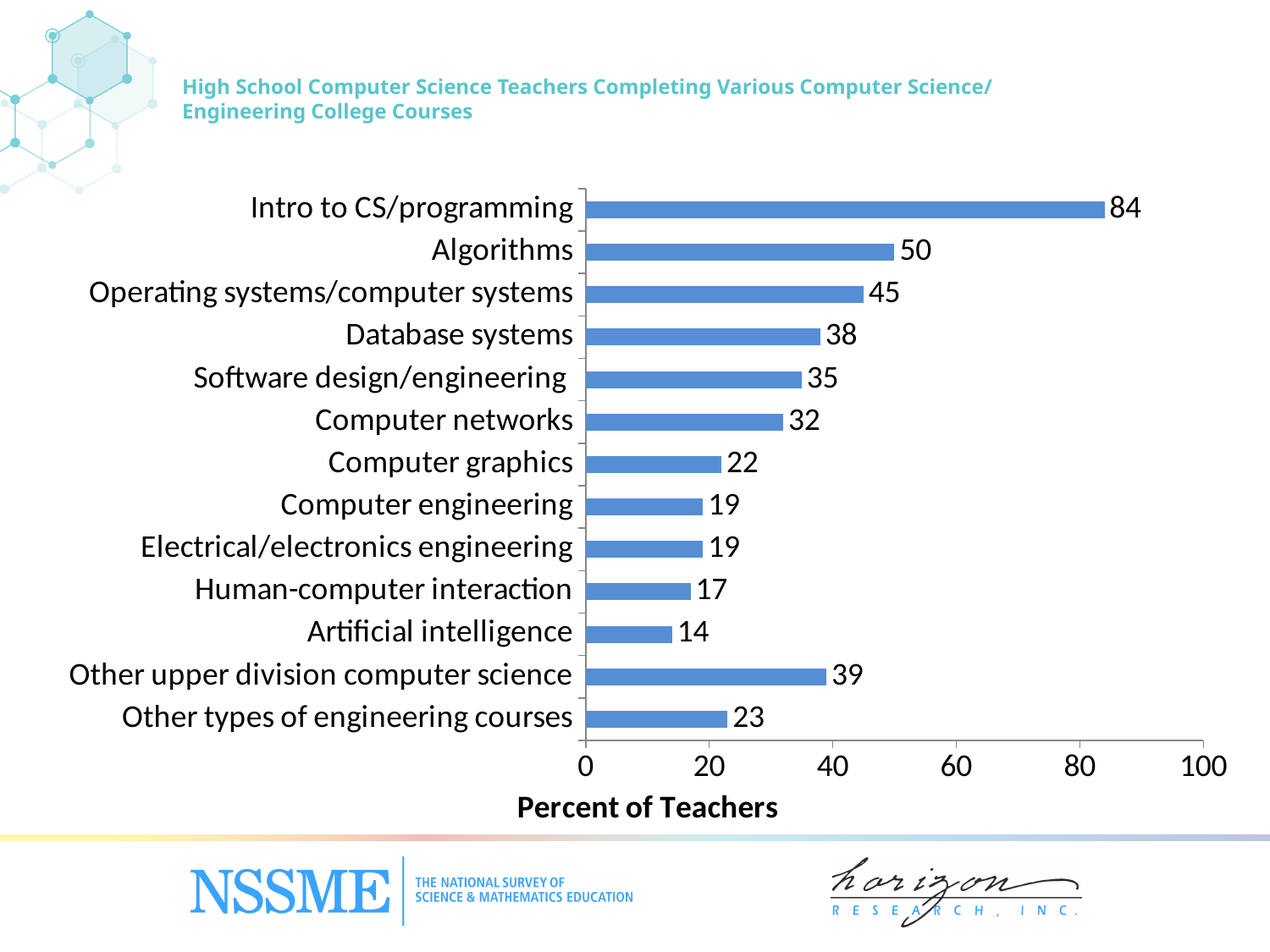
What kind of chart is shown on the slide? Bar chart What percent of teachers completed an Intro to CS/programming course? 84 Which course has the lowest percent of teachers? Artificial intelligence What percent of teachers completed a Human-computer interaction course? 17 What is the value for Database systems? 38 What is the label of the horizontal axis? Percent of Teachers Is the value for Operating systems/computer systems greater or less than 40? greater What is the difference between the values for Algorithms and Computer networks? 18 How many course categories are shown in the chart? 13 What is the difference between the values for Computer graphics and Other types of engineering courses? 1 Which course has the highest percent of teachers? Intro to CS/programming Which is larger, the value for Other upper division computer science or the value for Database systems? Other upper division computer science